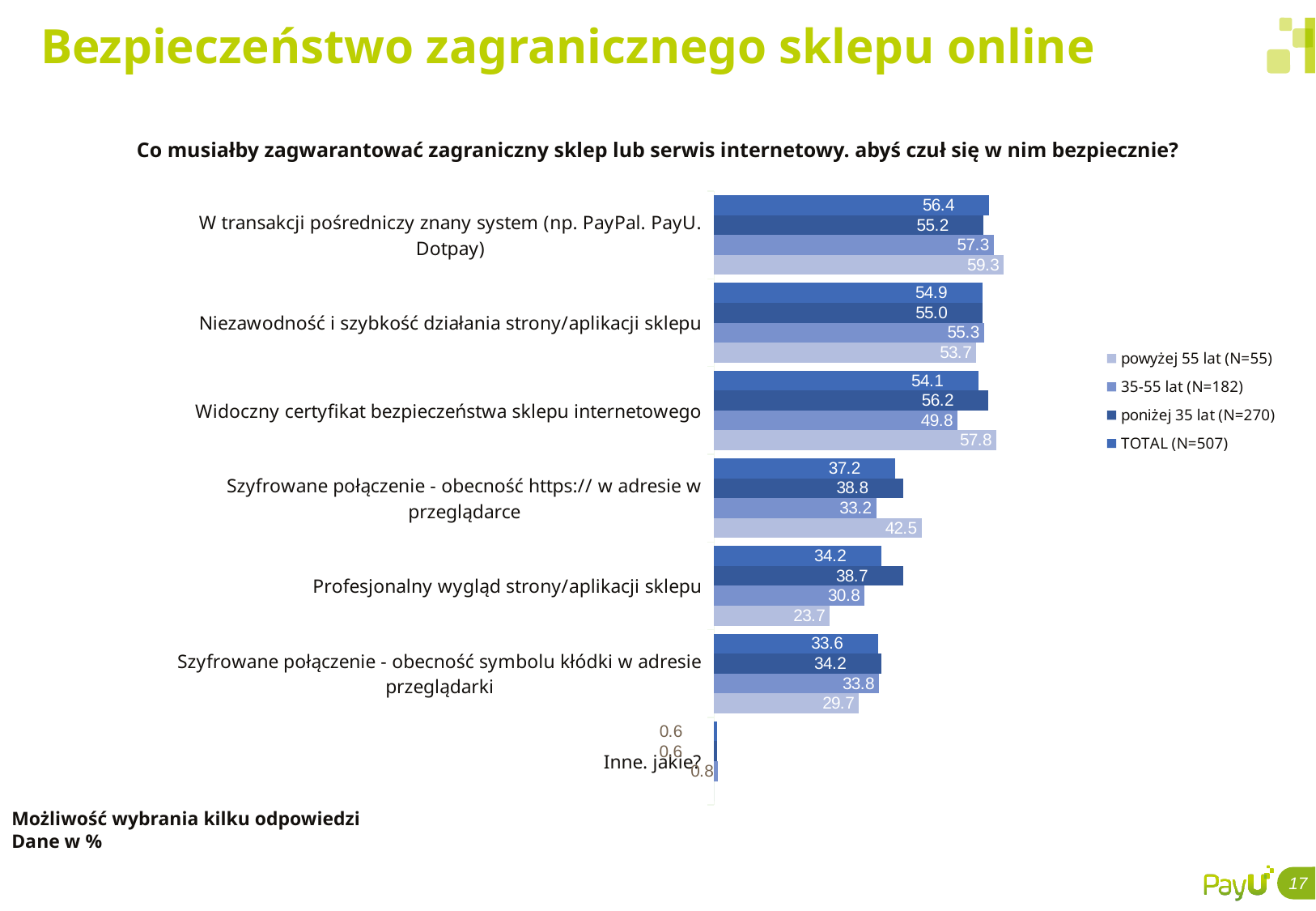
For "Widoczny certyfikat bezpieczeństwa sklepu internetowego", which is larger: the value for "poniżej 35 lat (N=270)" or for "35-55 lat (N=182)"? poniżej 35 lat (N=270) What kind of chart is shown on the slide? bar chart What is the TOTAL (N=507) value for "W transakcji pośredniczy znany system (np. PayPal. PayU. Dotpay)"? 56.4 What is the value for "powyżej 55 lat (N=55)" for "Szyfrowane połączenie - obecność https:// w adresie w przeglądarce"? 42.5 Which category has the highest TOTAL (N=507) value? W transakcji pośredniczy znany system (np. PayPal. PayU. Dotpay) How many series does the legend list? 4 Which category has the lowest value for "powyżej 55 lat (N=55)" among the six main categories (excluding "Inne. jakie?")? Profesjonalny wygląd strony/aplikacji sklepu What is the difference between the "powyżej 55 lat (N=55)" and "35-55 lat (N=182)" values for "Profesjonalny wygląd strony/aplikacji sklepu"? 7.1 What is the question shown as the chart's title? Co musiałby zagwarantować zagraniczny sklep lub serwis internetowy. abyś czuł się w nim bezpiecznie? What is the value for "poniżej 35 lat (N=270)" for "Profesjonalny wygląd strony/aplikacji sklepu"? 38.7 How many categories are shown on the chart? 7 What is the value for "35-55 lat (N=182)" for "Widoczny certyfikat bezpieczeństwa sklepu internetowego"? 49.8